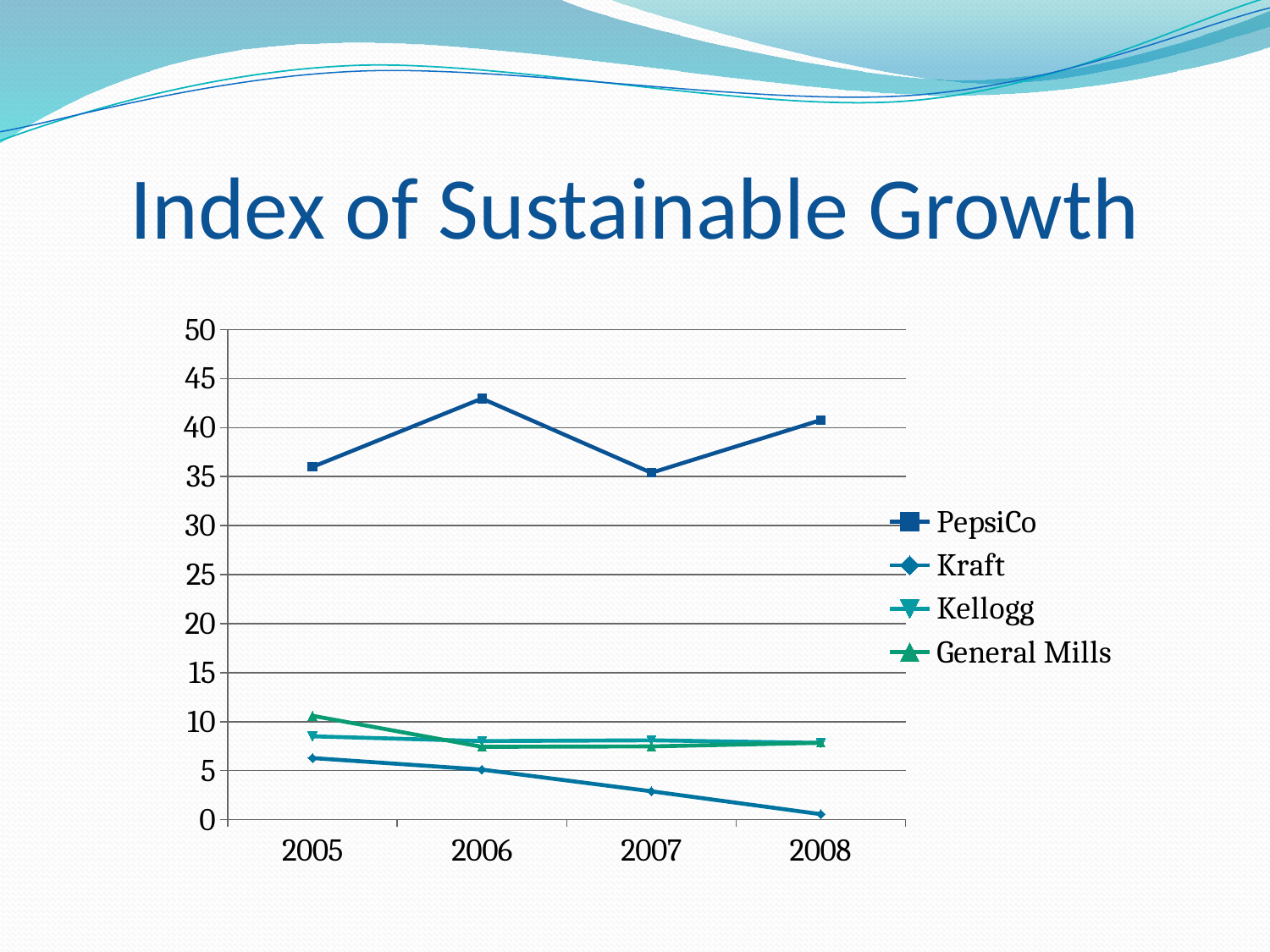
Is the value for Kellogg in 2005 greater or less than 10? less Is the value for Kraft in 2008 greater or less than 5? less Do Kraft's values rise or fall from 2005 to 2008? fall Which is larger for PepsiCo, the value in 2006 or the value in 2007? 2006 Is the value for PepsiCo in 2006 greater or less than 40? greater How many years are shown on the x axis? 4 Which company has the lowest value in 2008? Kraft In which year does PepsiCo reach its highest value? 2006 How many series does the legend list? 4 What kind of chart is shown on the slide? line chart What is the title of the slide? Index of Sustainable Growth Which company has the highest index values across all years? PepsiCo